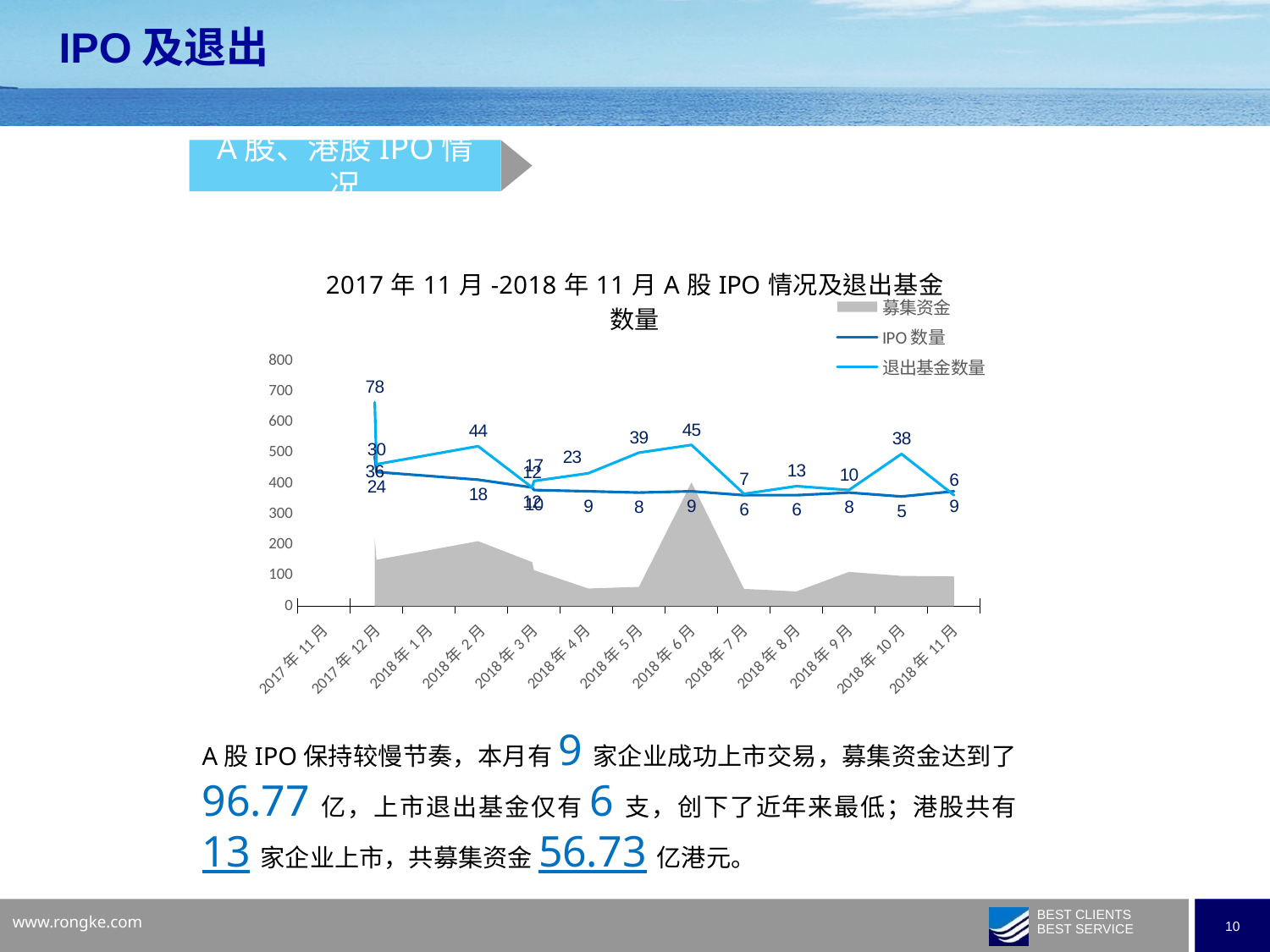
What is the difference between 退出基金数量 in 2018年6月 and 2018年7月? 38 What is the value of 退出基金数量 for 2018年11月? 6 Is the value of 募集资金 for 2018年6月 greater or less than 300? greater How many months are shown on the x axis of the chart? 13 What is the value of 退出基金数量 for 2018年6月? 45 What is the value of IPO数量 for 2018年10月? 5 How many series does the chart legend list? 3 In which month is 退出基金数量 lowest? 2018年11月 Does IPO数量 rise or fall from 2018年2月 to 2018年7月? fall What is the title of the chart? 2017年11月-2018年11月A股IPO情况及退出基金数量 In which month is IPO数量 lowest? 2018年10月 Which is larger, 退出基金数量 in 2018年2月 or in 2018年5月? 2018年5月